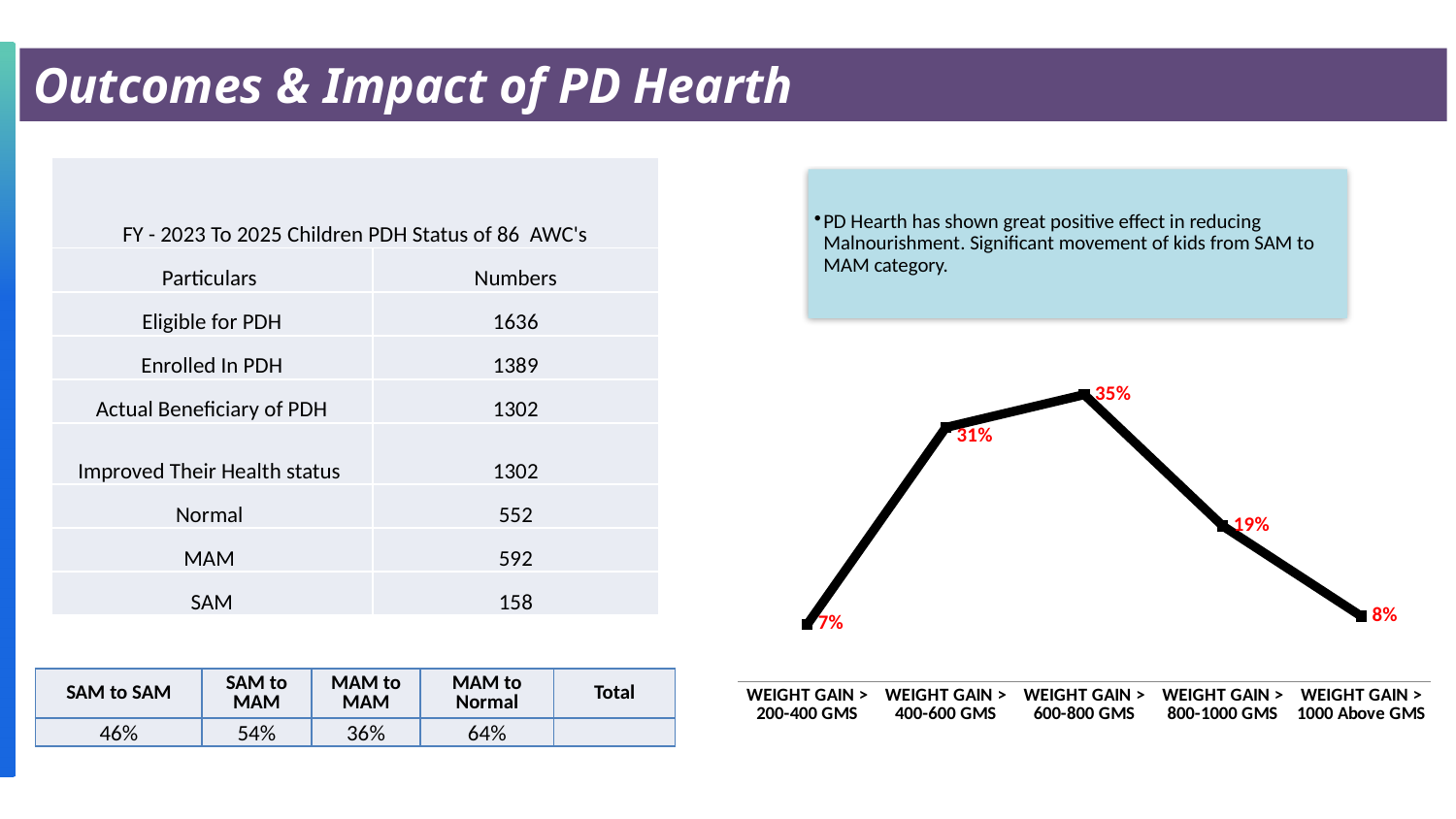
Which is larger, the value for WEIGHT GAIN > 400-600 GMS or WEIGHT GAIN > 1000 Above GMS? WEIGHT GAIN > 400-600 GMS What is the value for WEIGHT GAIN > 600-800 GMS? 35% What is the difference between the values for WEIGHT GAIN > 600-800 GMS and WEIGHT GAIN > 800-1000 GMS? 16% What kind of chart is shown on the slide? Line chart What is the value for WEIGHT GAIN > 400-600 GMS? 31% What is the value for WEIGHT GAIN > 800-1000 GMS? 19% Which weight gain category has the lowest value? WEIGHT GAIN > 200-400 GMS How many weight gain categories are plotted on the chart? 5 Which weight gain category has the highest value? WEIGHT GAIN > 600-800 GMS What is the value for WEIGHT GAIN > 200-400 GMS? 7% Do the values rise or fall from WEIGHT GAIN > 600-800 GMS to WEIGHT GAIN > 1000 Above GMS? Fall What is the value for WEIGHT GAIN > 1000 Above GMS? 8%